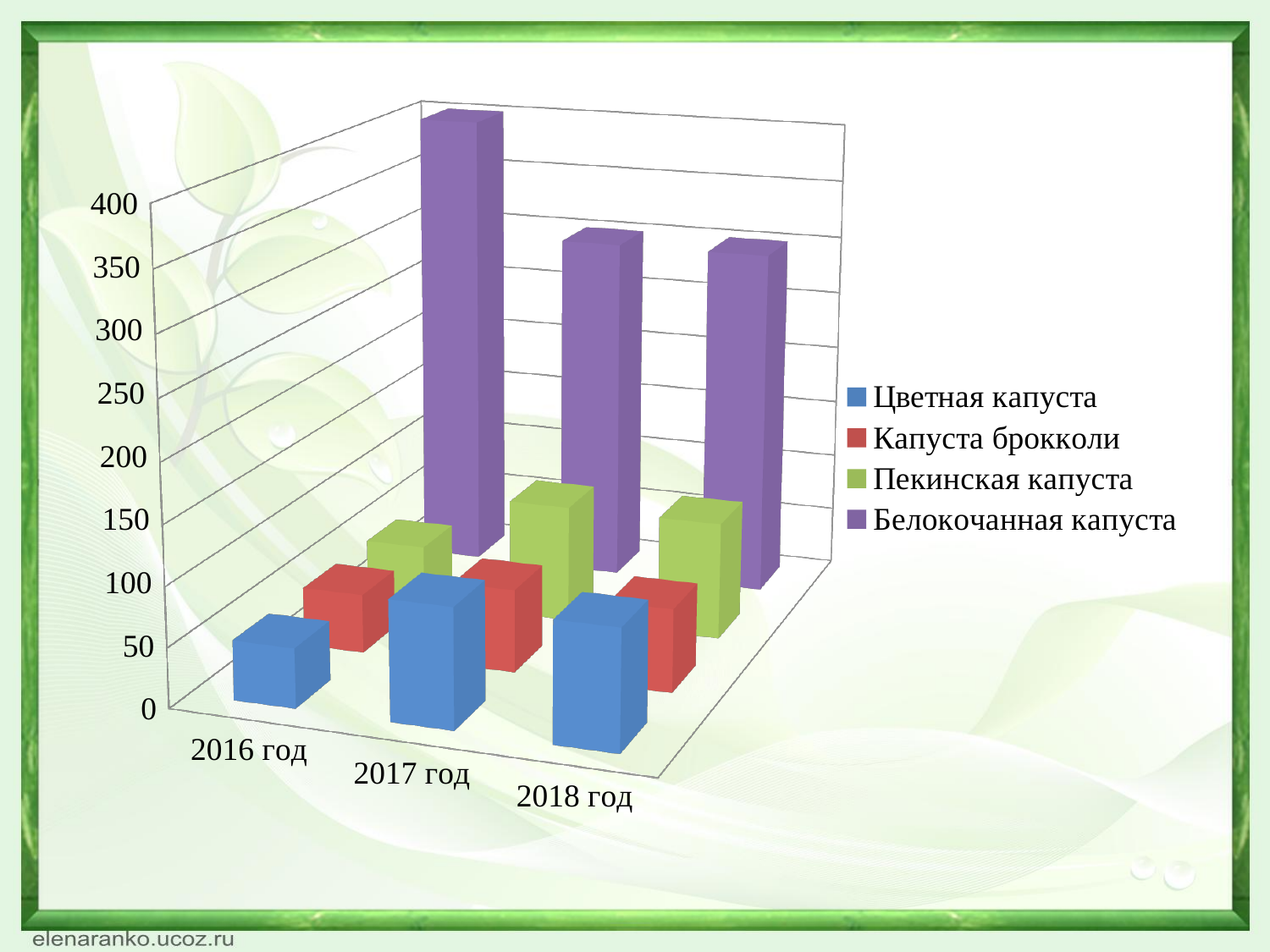
What colour represents Белокочанная капуста in the legend? purple What kind of chart is shown on the slide? bar chart Is the value for Белокочанная капуста in 2016 год greater or less than 300? greater How many years are shown on the x axis? 3 Which series has the highest value in 2016 год? Белокочанная капуста Which is larger: Белокочанная капуста in 2016 год or in 2017 год? 2016 год In which year is the value for Белокочанная капуста the highest? 2016 год Does the value for Белокочанная капуста rise or fall from 2016 год to 2018 год? fall How many series does the legend list? 4 Which is larger: Пекинская капуста in 2016 год or in 2017 год? 2017 год Is the value for Цветная капуста in 2016 год greater or less than 150? less